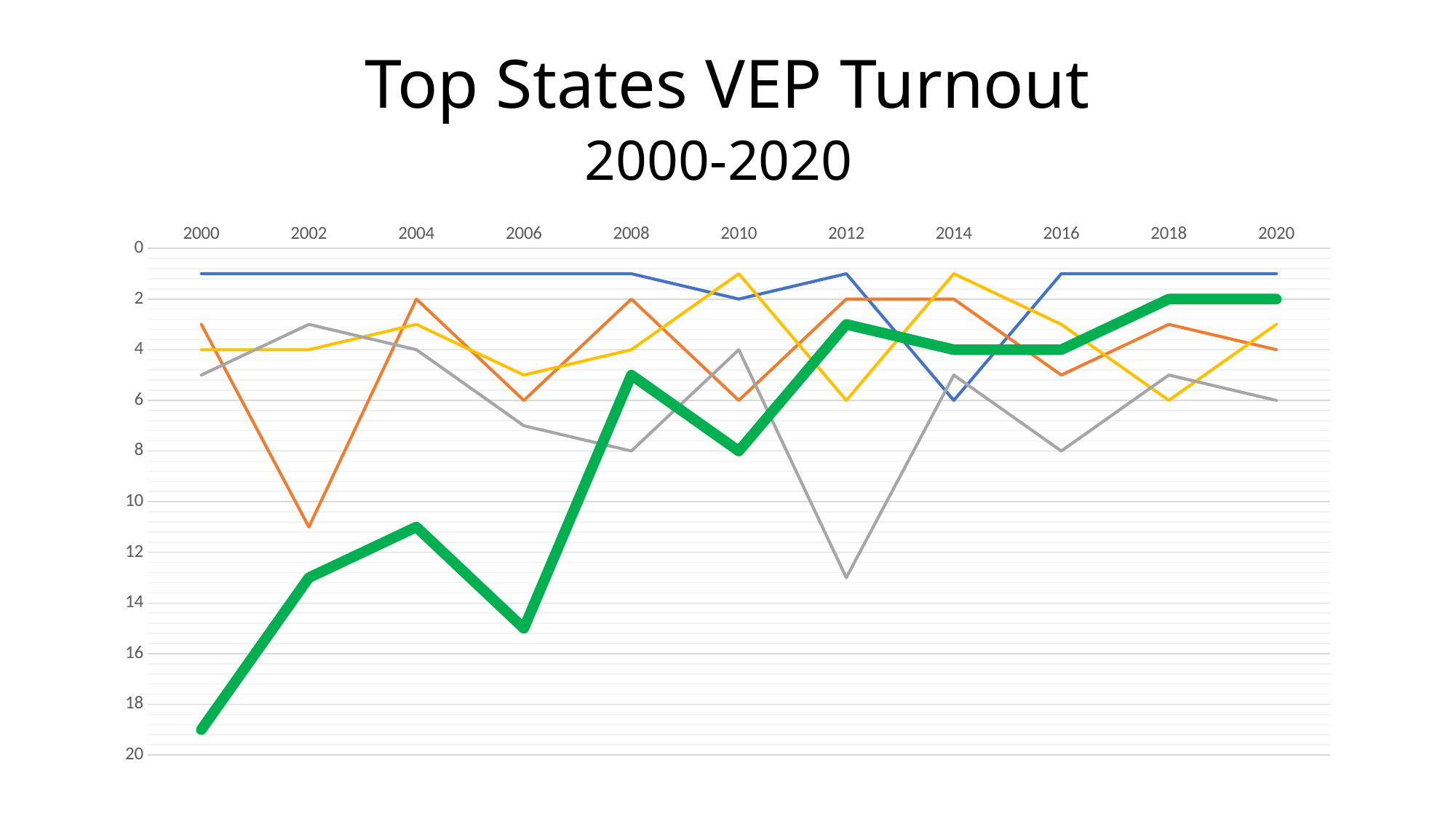
In which year does the thick green line reach its highest value? 2000 Is the value of the thick green line in 2006 greater or less than 14? greater What is the value of the grey line in 2016? 8 What is the value of the thick green line in 2020? 2 How many years are shown along the x axis? 11 What is the value of the thick green line in 2010? 8 What kind of chart is shown on the slide? line chart How many lines are plotted on the chart? 5 Is the value of the orange line in 2002 greater or less than 10? greater What is the title of the chart? Top States VEP Turnout 2000-2020 What is the difference between the thick green line's value in 2010 and its value in 2020? 6 What is the value of the yellow line in 2012? 6